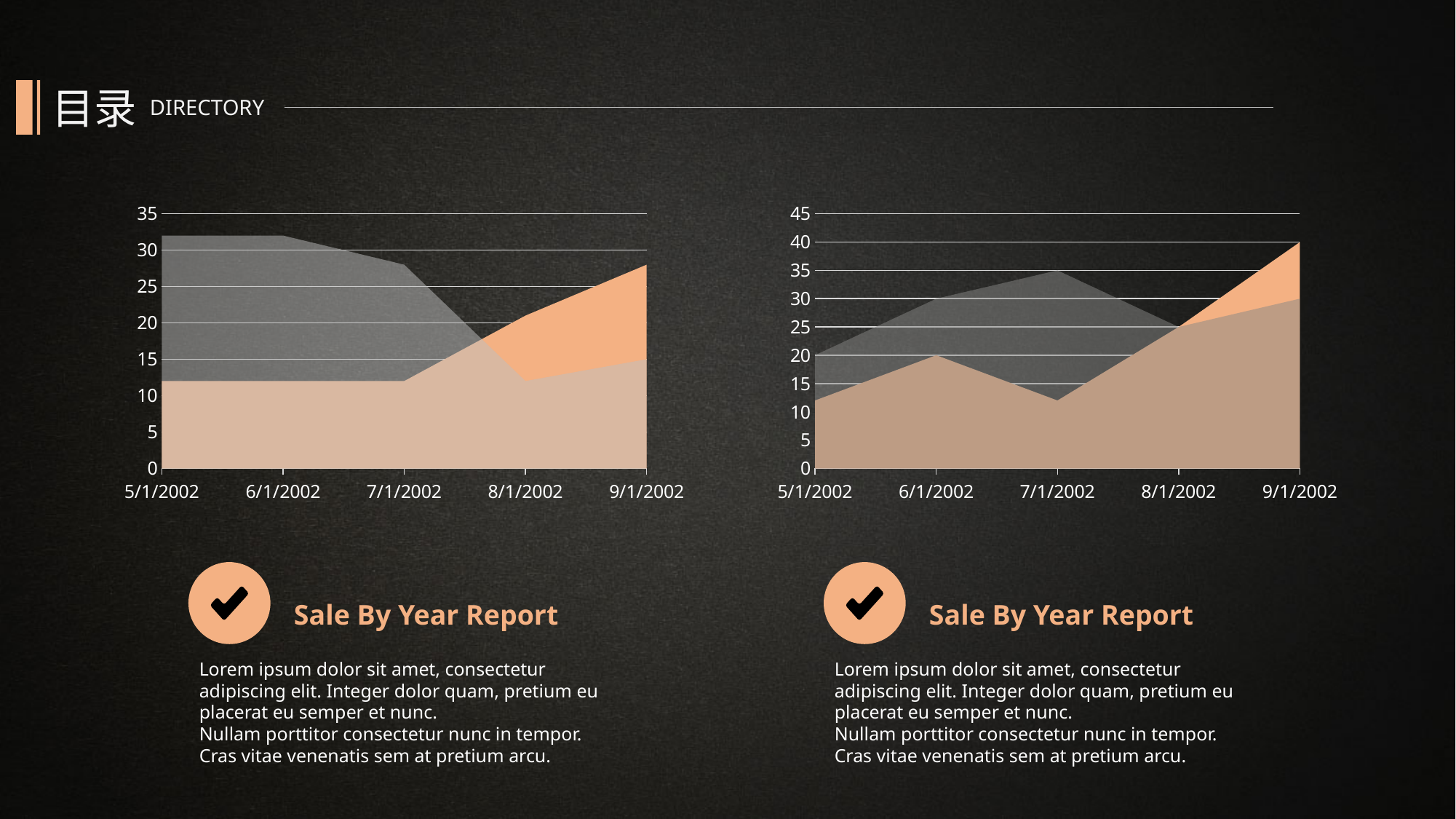
In the left chart, at which date is the upper (gray/orange) series at its lowest? 8/1/2002 In the right chart, is the value of the upper (gray) series at 7/1/2002 greater or less than 30? greater How many dates are shown on the x axis of the right chart? 5 In the right chart, at which date does the upper (gray) series reach its highest value? 7/1/2002 What is the highest value shown on the y axis of the right chart? 45 In the left chart, does the upper series rise or fall from 5/1/2002 to 8/1/2002? fall In the left chart, is the value of the lower (tan) series at 8/1/2002 greater or less than 15? greater In the right chart, what is the value of the upper (gray) series at 9/1/2002? 30 In the left chart, is the upper series larger at 5/1/2002 or at 8/1/2002? 5/1/2002 What kind of chart is the left chart on the slide? area chart In the right chart, is the value of the lower (tan) series at 9/1/2002 greater or less than 25? greater In the right chart, what is the value of the lower (tan) series at 6/1/2002? 20